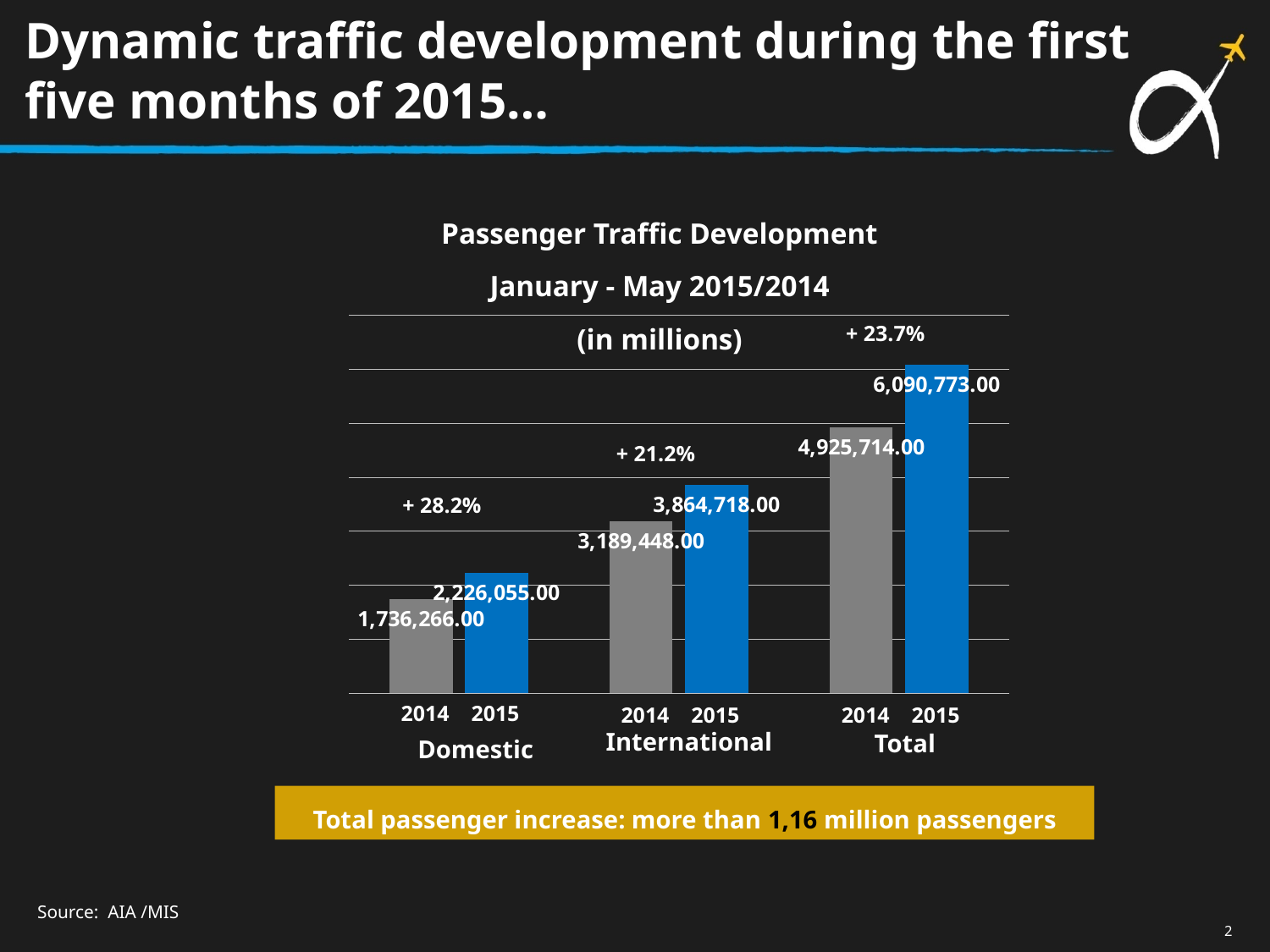
What is the difference between the Total values for 2015 and 2014? 1,165,059.00 What is the difference between the Domestic values for 2015 and 2014? 489,789.00 What is the Total passenger value for 2015? 6,090,773.00 Which is larger, the International 2015 value or the Total 2014 value? Total 2014 What percentage increase is shown above the International bars? + 21.2% What is the Domestic passenger value for 2015? 2,226,055.00 Which bar has the highest value in the chart? Total 2015 How many categories are shown on the x axis of the chart? 3 What percentage increase is shown above the Domestic bars? + 28.2% Which bar has the lowest value in the chart? Domestic 2014 What type of chart is shown on the slide? Bar chart What is the International passenger value for 2014? 3,189,448.00